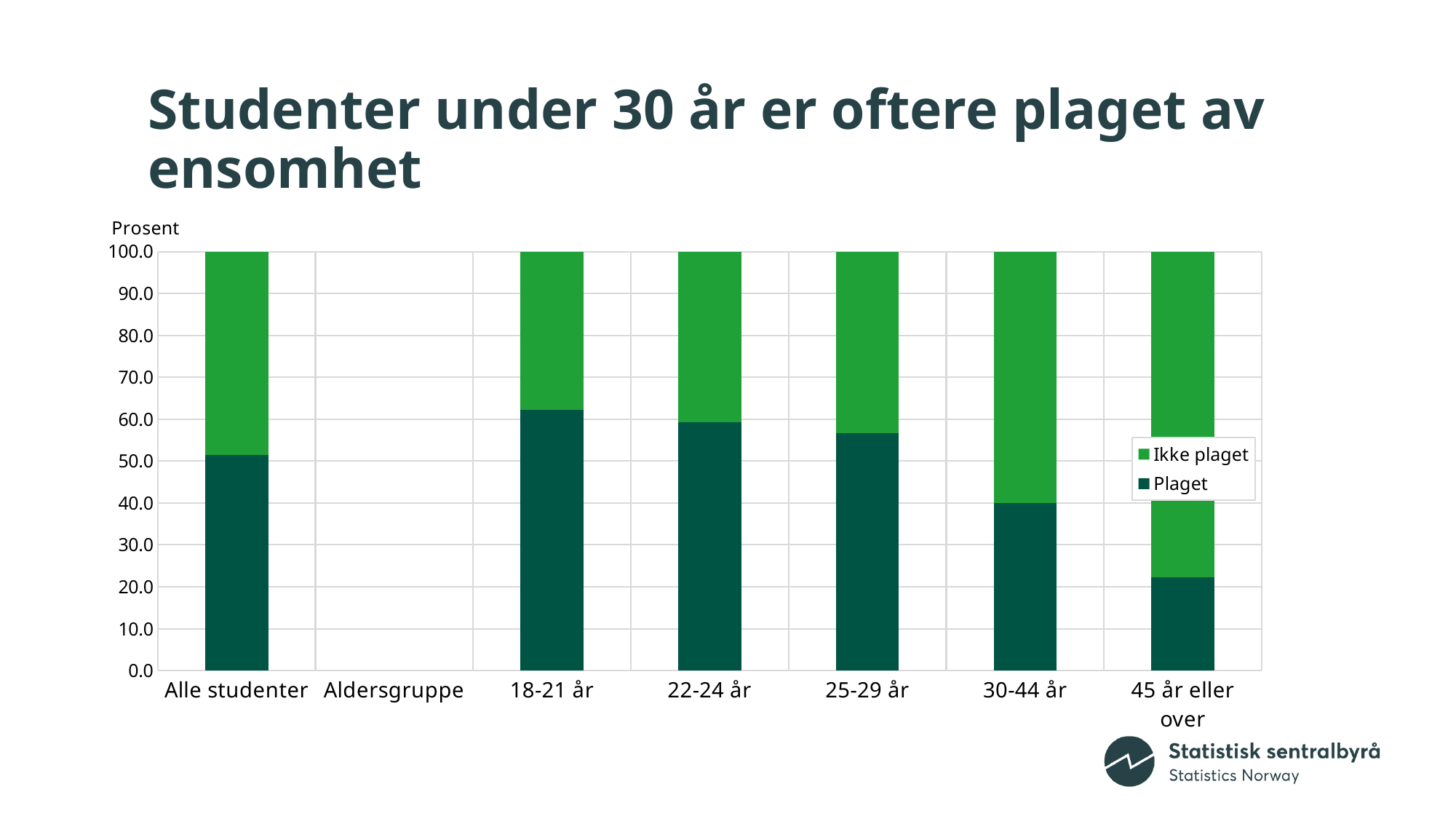
Is the Plaget value for 25-29 år greater or less than 60.0? less What kind of chart is shown on the slide? Stacked bar chart What are the two series named in the legend? Ikke plaget and Plaget Is the Plaget value for 45 år eller over greater or less than 30.0? less Which age group has the lowest value for Plaget? 45 år eller over Which is larger, the Plaget value for 30-44 år or for 45 år eller over? 30-44 år Moving from 18-21 år to 45 år eller over, does the Plaget value rise or fall? fall Is the Plaget value for 22-24 år greater or less than 50.0? greater Which age group has the largest Ikke plaget segment? 45 år eller over How many series does the legend list? 2 Which age group has the highest value for Plaget? 18-21 år What is the label on the vertical axis? Prosent